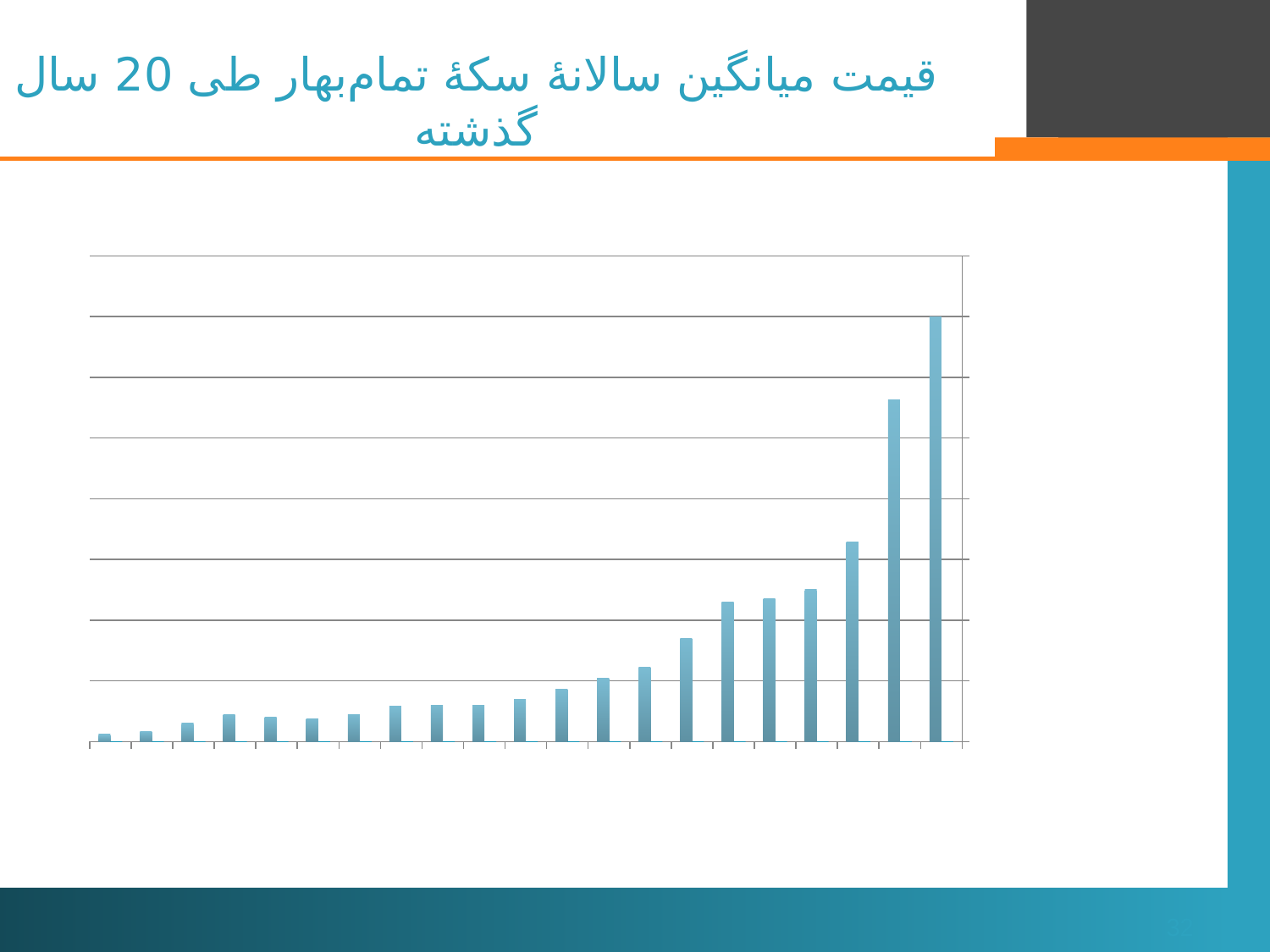
Which bar is the tallest in the chart? the rightmost (last) bar Which is taller, the leftmost bar or the rightmost bar? the rightmost bar What colour are the bars in the chart? blue Do the bar values generally rise or fall from left to right along the x axis? rise What kind of chart is shown on the slide? bar chart What is the title of the slide containing the chart? قیمت میانگین سالانۀ سکۀ تمام‌بهار طی 20 سال گذشته How many bars are plotted in the chart? 21 Which bar is the shortest in the chart? the leftmost (first) bar Which is taller, the rightmost bar or the bar immediately to its left? the rightmost bar